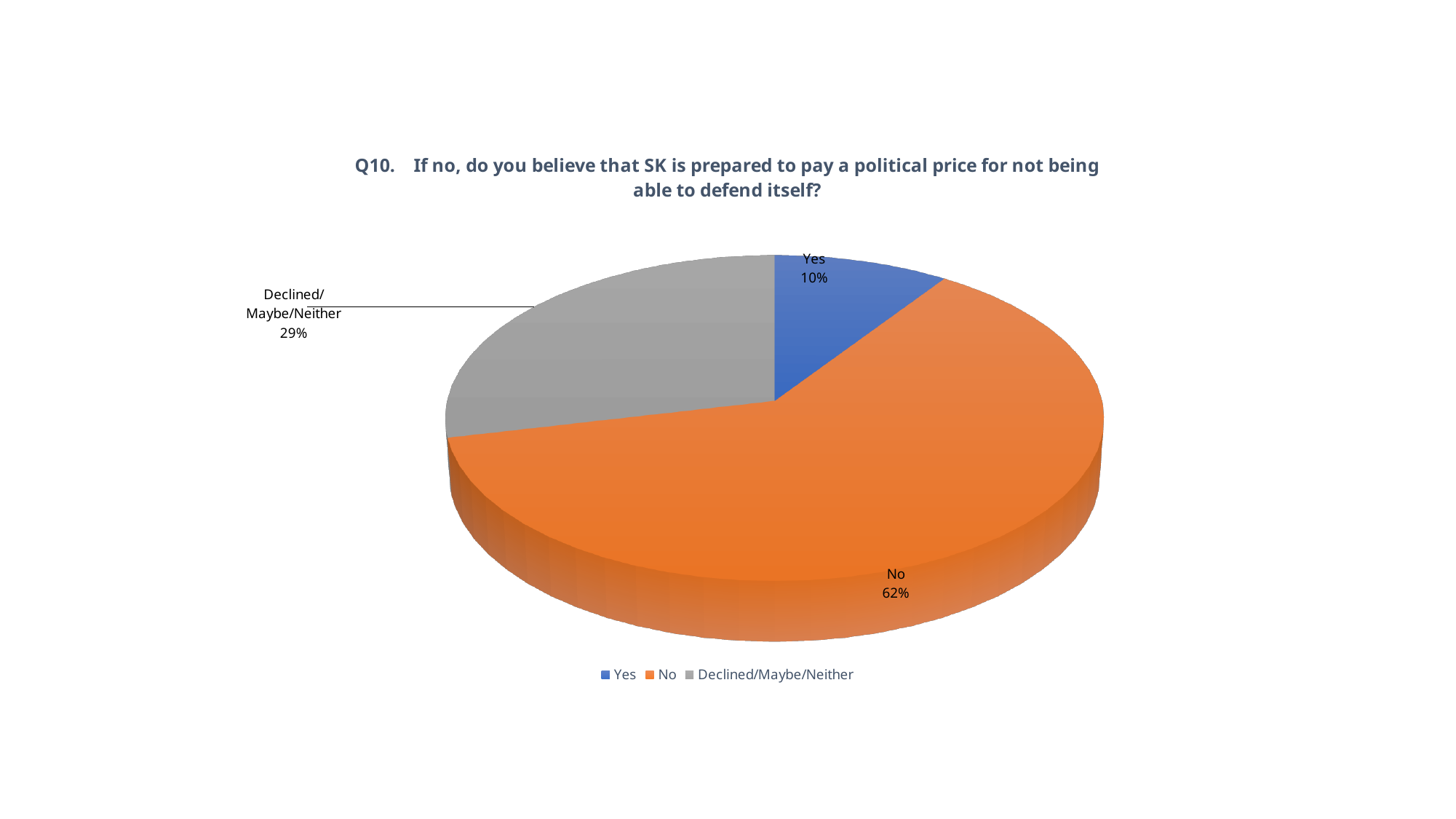
What is the difference in percentage points between the "Declined/Maybe/Neither" slice and the "Yes" slice? 19 What share of the pie is labelled "Yes"? 10% What share of the pie is labelled "Declined/Maybe/Neither"? 29% Which category has the smallest slice of the pie? Yes Which is larger, the "Declined/Maybe/Neither" slice or the "Yes" slice? Declined/Maybe/Neither Which category has the largest slice of the pie? No What share of the pie is labelled "No"? 62% What kind of chart is shown on the slide? Pie chart What colour is the "No" slice of the pie? Orange What is the difference in percentage points between the "No" slice and the "Yes" slice? 52 How many entries does the legend list? 3 How many slices does the pie chart have? 3